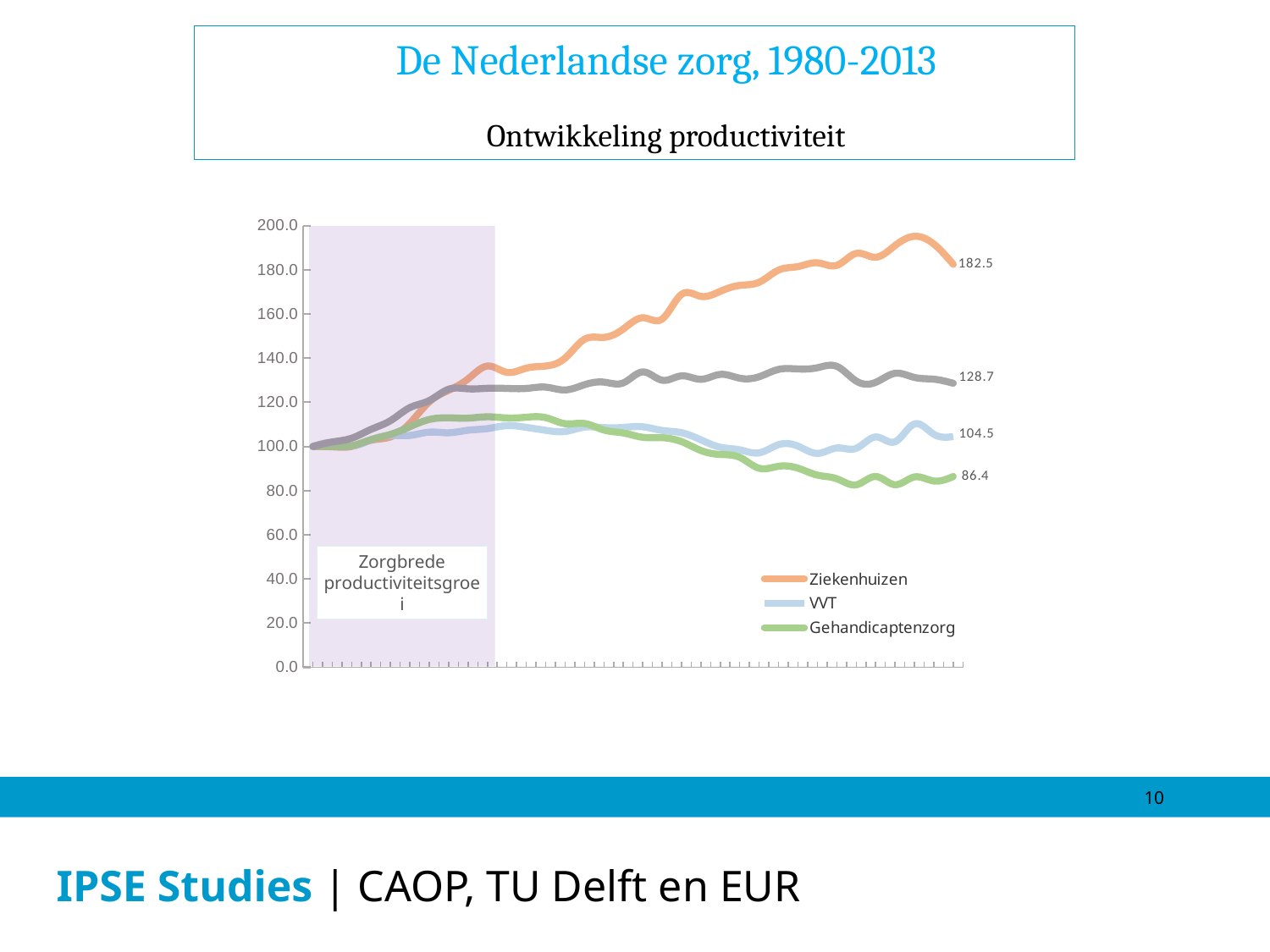
Which ends higher, Ziekenhuizen or VVT? Ziekenhuizen What is the final value shown for VVT? 104.5 What is the final value shown for Gehandicaptenzorg? 86.4 Which series ends at the highest value? Ziekenhuizen What is the subtitle of the chart shown on the slide? Ontwikkeling productiviteit What kind of chart is shown on the slide? line chart How many series does the legend list? 3 What is the final value shown for Ziekenhuizen? 182.5 Which series ends at the lowest value? Gehandicaptenzorg What is the difference between the final values of Ziekenhuizen and Gehandicaptenzorg? 96.1 Does the Ziekenhuizen line generally rise or fall along the x axis? rise What is the difference between the final values of VVT and Gehandicaptenzorg? 18.1